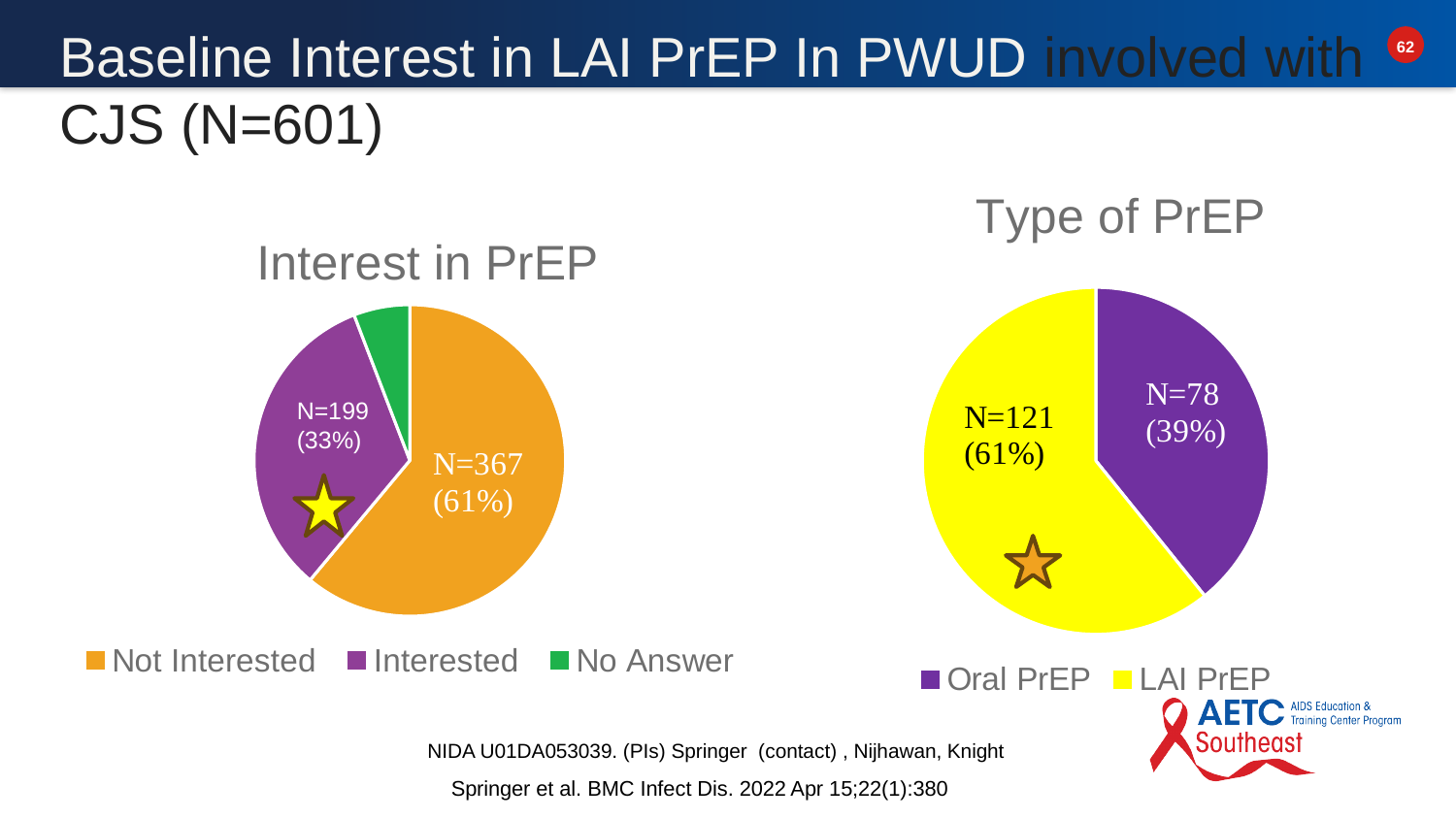
In the 'Type of PrEP' chart, what is the difference in N between LAI PrEP and Oral PrEP? 43 In the 'Interest in PrEP' chart, which category has the largest slice? Not Interested In the 'Interest in PrEP' chart, which category has the smallest slice? No Answer In the 'Type of PrEP' chart, what is the N value for LAI PrEP? N=121 In the 'Interest in PrEP' chart, what share of the pie is Not Interested? 61% In the 'Type of PrEP' chart, what percentage chose Oral PrEP? 39% What kind of chart is the 'Type of PrEP' chart? Pie chart In the 'Interest in PrEP' chart, what is the N value for Not Interested? N=367 In the 'Type of PrEP' chart, what colour represents LAI PrEP? Yellow In the 'Interest in PrEP' chart, how many categories does the legend list? 3 In the 'Type of PrEP' chart, which is larger, Oral PrEP or LAI PrEP? LAI PrEP In the 'Interest in PrEP' chart, what percentage of respondents were Interested? 33%